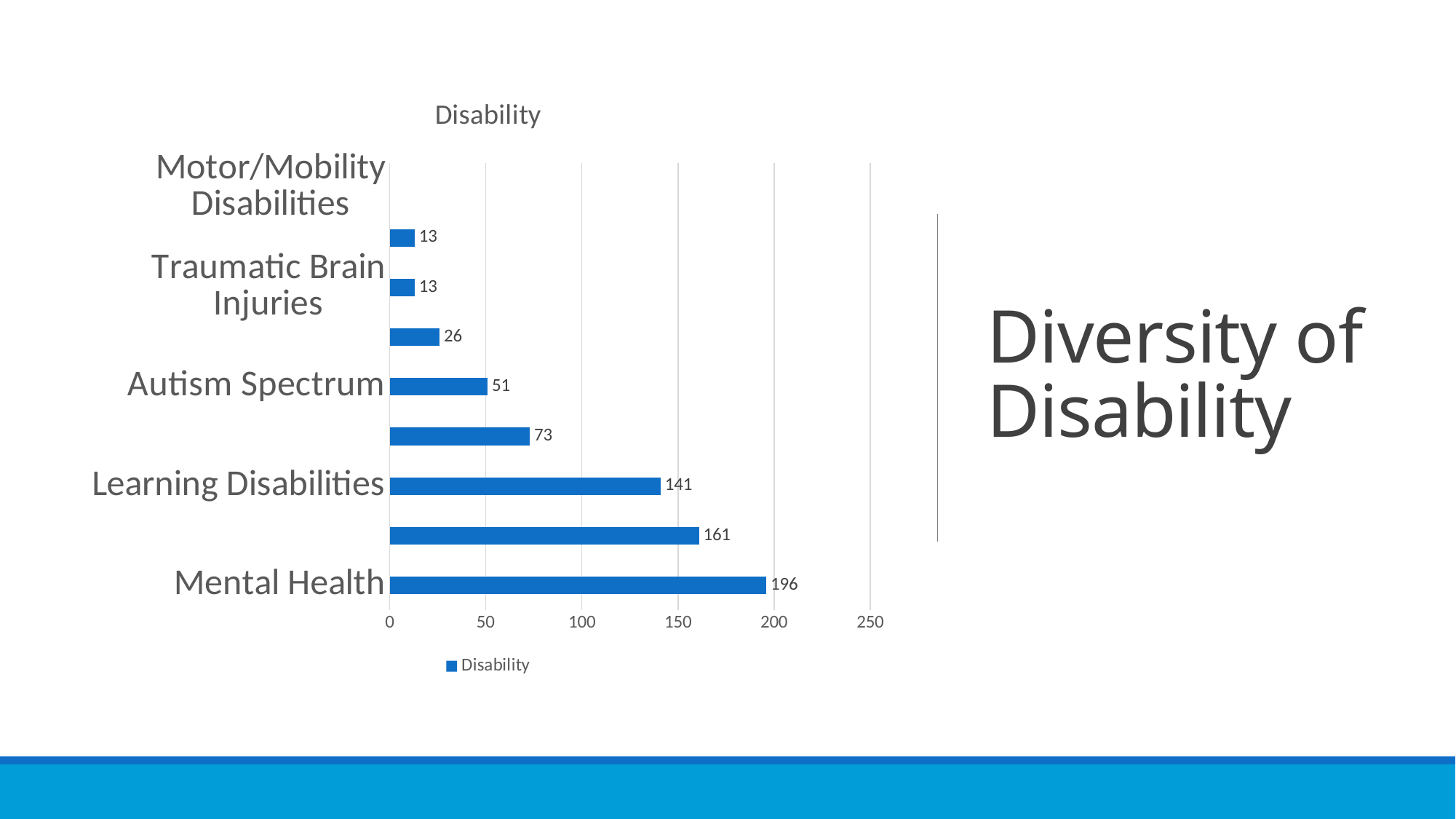
Which labelled category has the highest value? Mental Health What is the difference between the values for Learning Disabilities and Autism Spectrum? 90 What is the value for Mental Health? 196 How many series does the legend list? 1 Is the value for Mental Health greater or less than 150? greater What is the difference between the values for Mental Health and Learning Disabilities? 55 What is the title of the chart? Disability What is the value for Traumatic Brain Injuries? 13 What is the value for Autism Spectrum? 51 Which is larger, the value for Autism Spectrum or the value for Traumatic Brain Injuries? Autism Spectrum What kind of chart is shown on the slide? bar chart What is the value for Learning Disabilities? 141